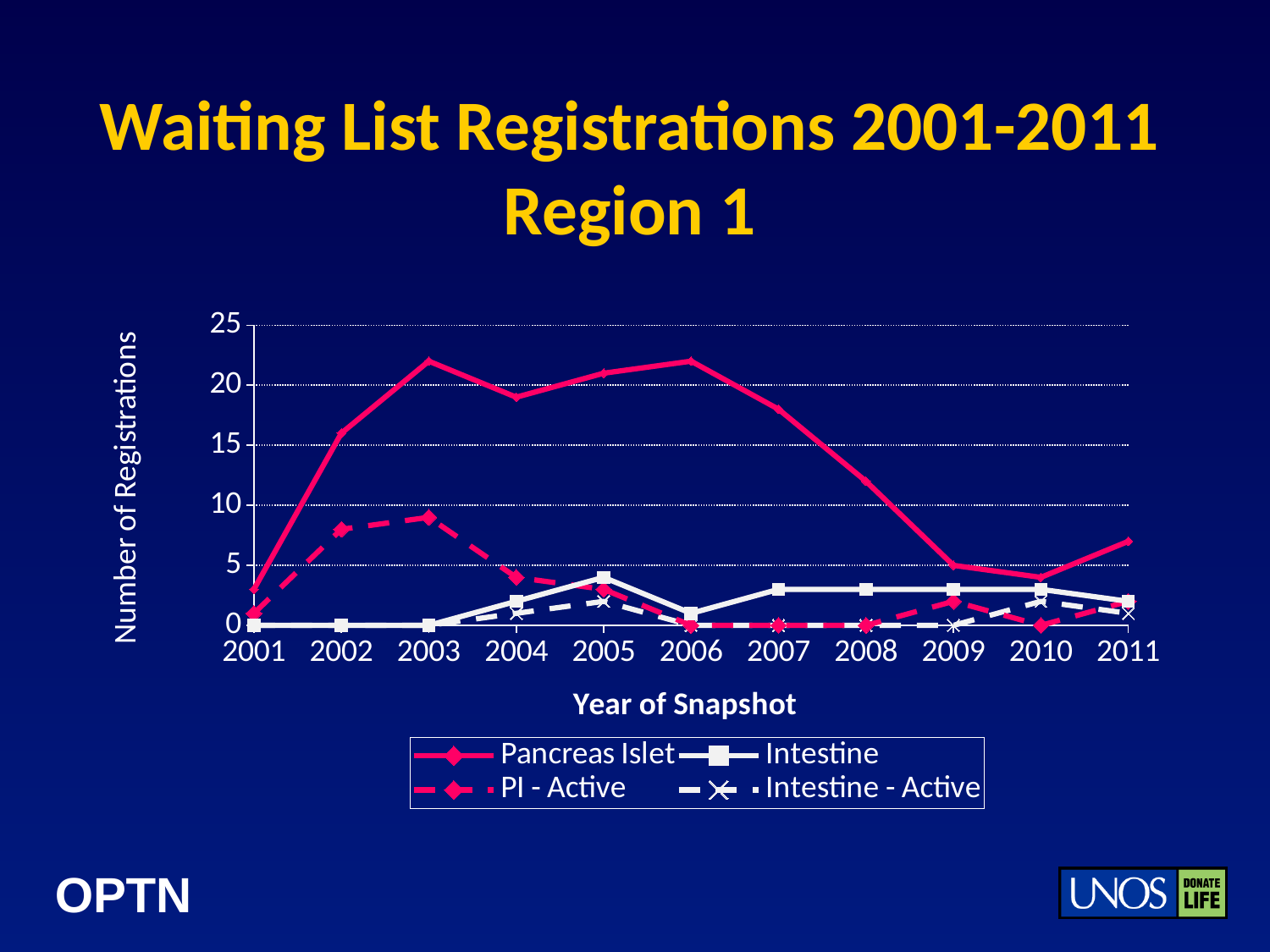
How many years are plotted along the x axis? 11 What kind of chart is shown on the slide? line chart Is the value for Pancreas Islet in 2003 greater or less than 20? greater Is the value for Pancreas Islet in 2007 greater or less than 15? greater Do the Pancreas Islet values rise or fall from 2006 to 2009? fall Which series has the highest value in 2005? Pancreas Islet How many series does the legend list? 4 Is the value for Pancreas Islet in 2011 greater or less than 5? greater Which is larger for Pancreas Islet: the value in 2003 or the value in 2009? 2003 What is the title of the y axis? Number of Registrations